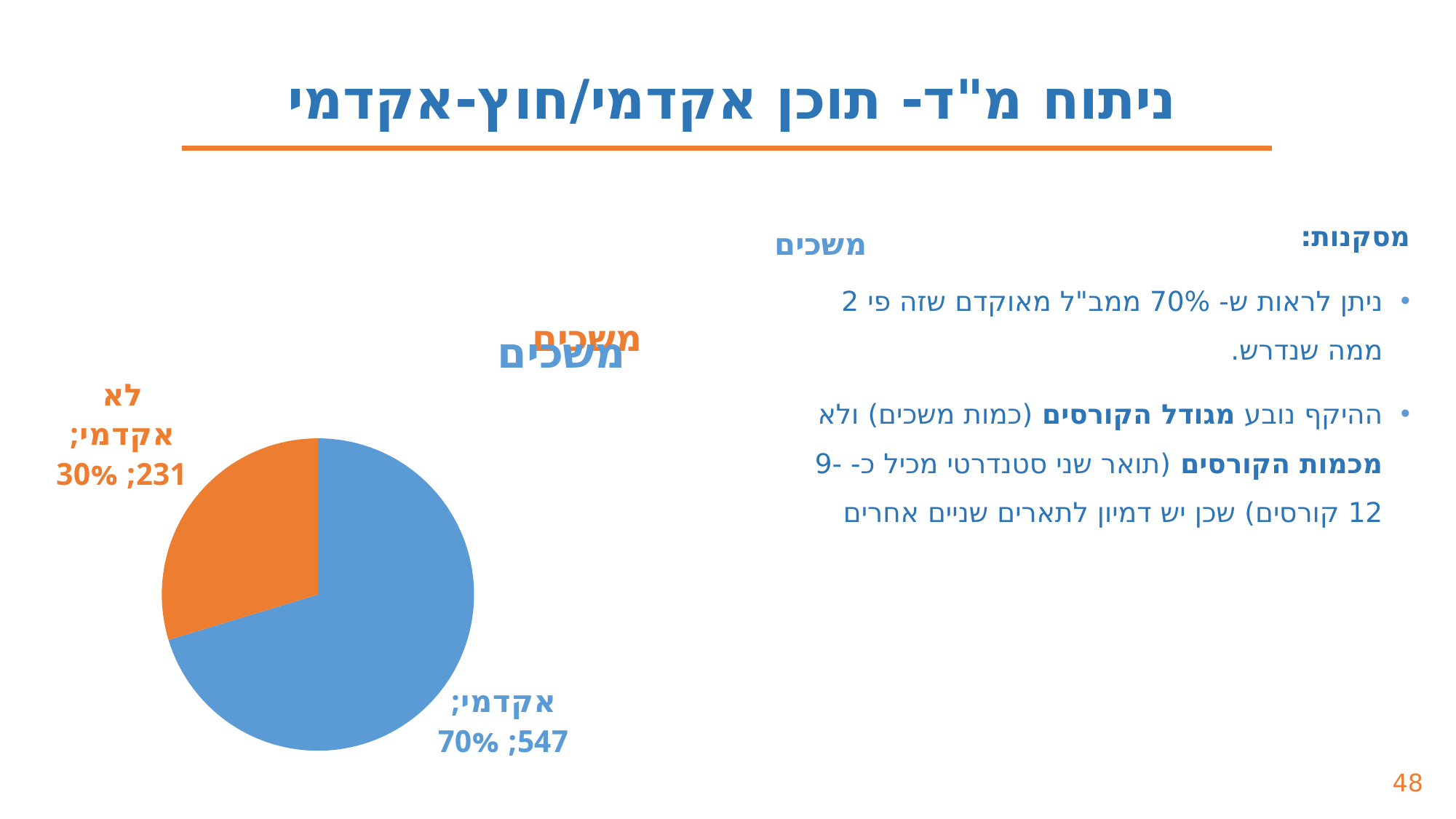
How many slices does the pie chart have? 2 Which is larger, the אקדמי slice or the לא אקדמי slice? אקדמי What share of the pie does the לא אקדמי slice represent? 30% What value is shown for the אקדמי slice? 547 Which slice is the largest in the pie chart? אקדמי What is the title of the pie chart? משכים What colour is the לא אקדמי slice? orange Which slice is the smallest in the pie chart? לא אקדמי What share of the pie does the אקדמי slice represent? 70% What kind of chart is shown on the slide? pie chart What value is shown for the לא אקדמי slice? 231 What is the difference between the אקדמי value and the לא אקדמי value? 316